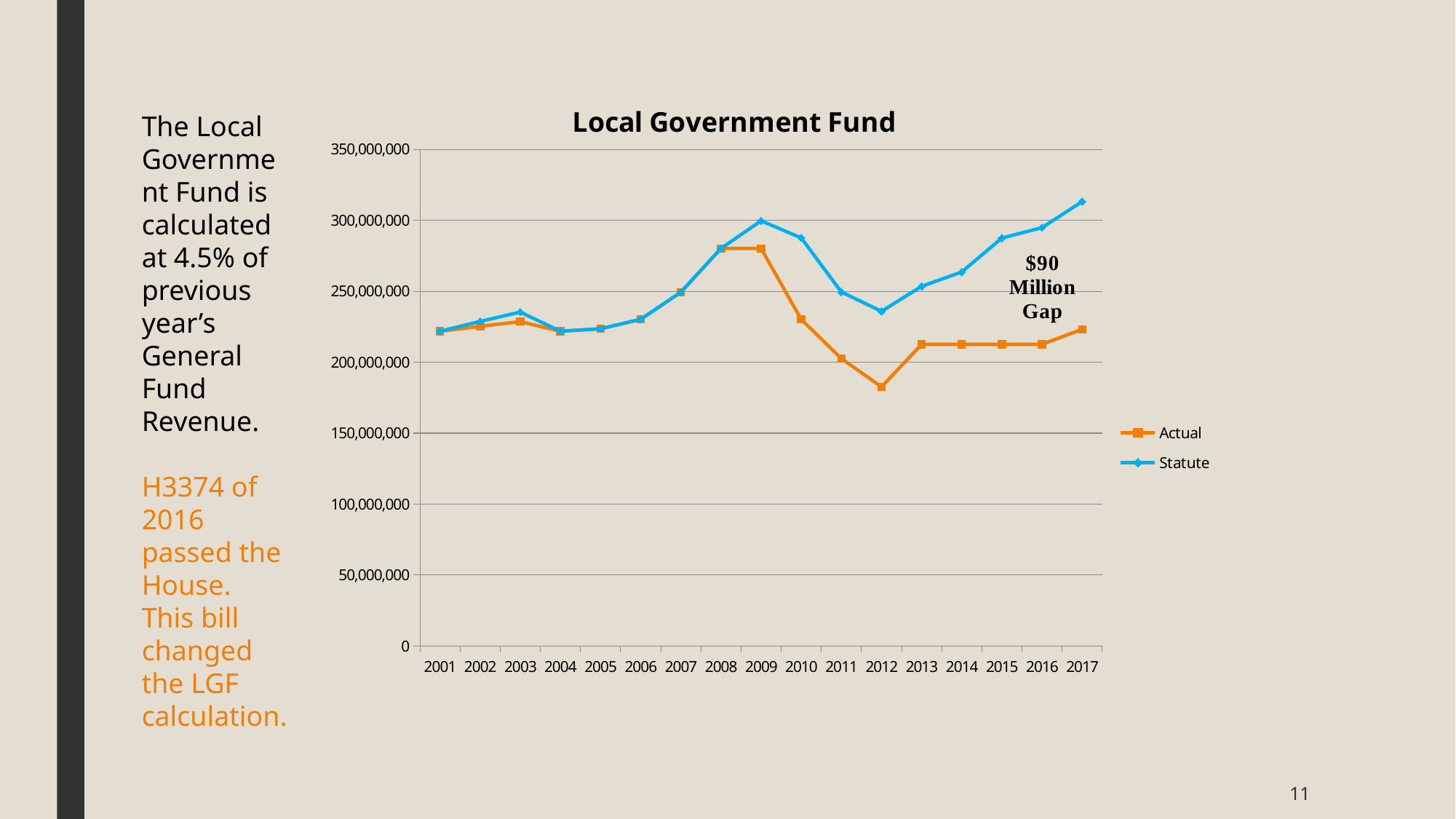
What is the title of the chart? Local Government Fund What kind of chart is shown on the slide? line chart In 2017, which series has the larger value, Actual or Statute? Statute Is the Actual value for 2009 greater or less than 250,000,000? greater How many series does the legend list? 2 Is the Statute value for 2012 greater or less than 250,000,000? less How many years are plotted along the x axis? 17 Is the Statute value for 2017 greater or less than 300,000,000? greater In which year is the Actual series at its lowest? 2012 Which series is drawn in orange? Actual In which year is the Statute series at its highest? 2017